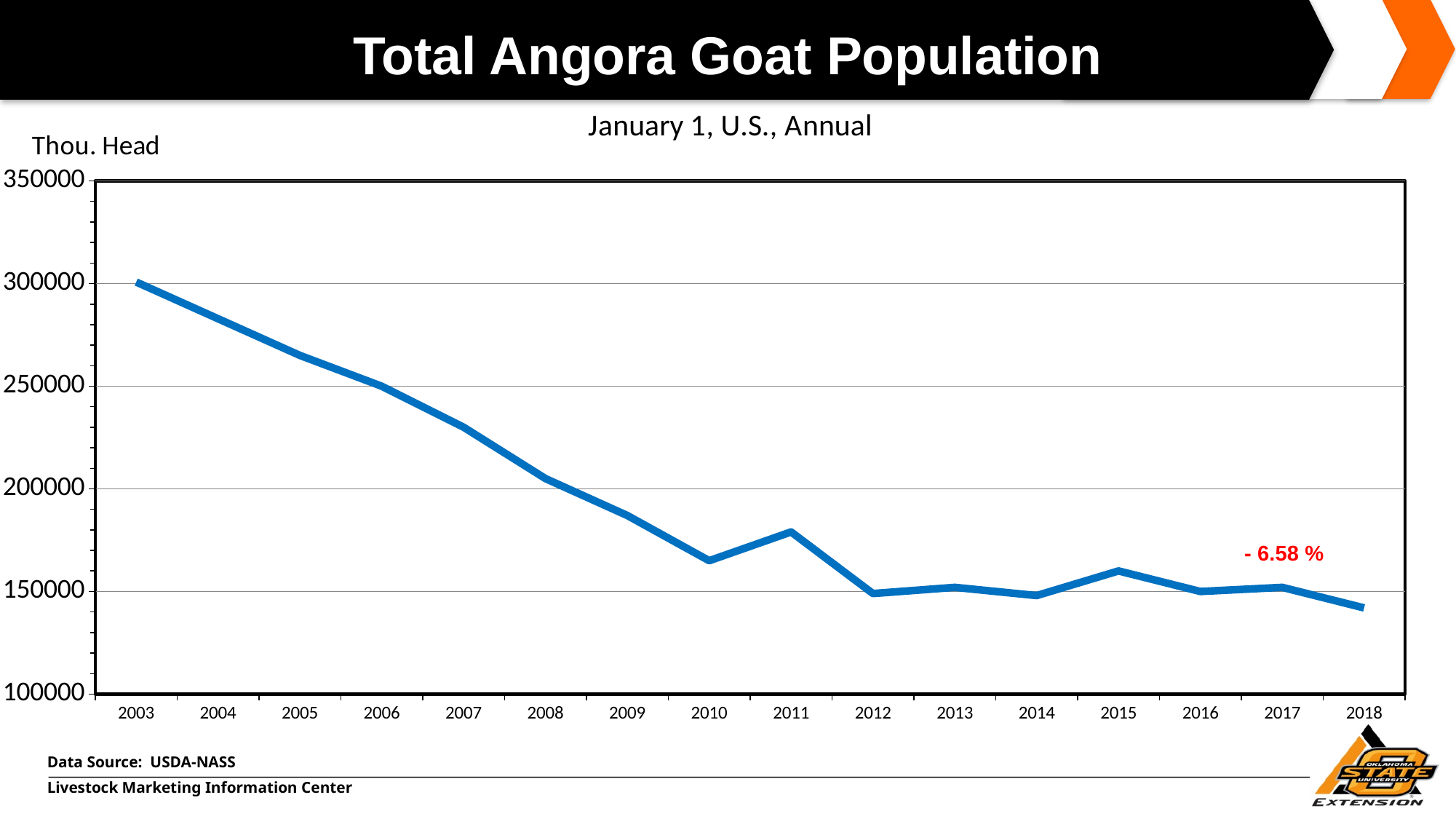
Which year has the highest Angora goat population? 2003 Is the value for 2005 greater or less than 250000? greater Which year has the larger value, 2010 or 2011? 2011 Which year has the lowest Angora goat population? 2018 Is the value for 2010 greater or less than 200000? less How many years are plotted on the x axis? 16 What kind of chart is shown on the slide? line chart Which year has the larger value, 2008 or 2009? 2008 Is the value for 2007 greater or less than 200000? greater What unit label is shown above the y axis? Thou. Head Overall, do the values rise or fall from 2003 to 2018? fall